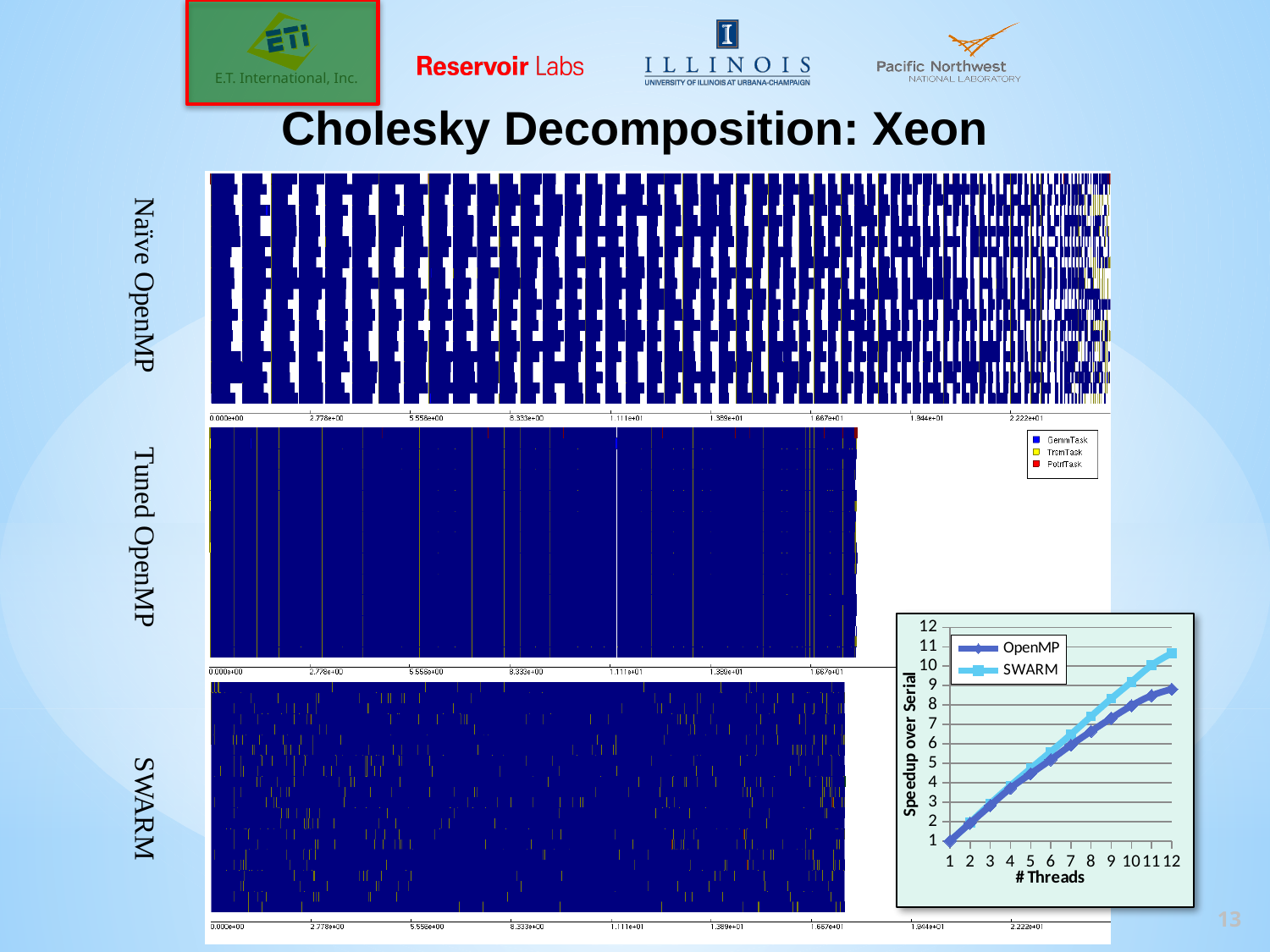
In the speedup chart, is the OpenMP speedup at 12 threads greater or less than 10? less In the speedup chart, which series reaches the highest speedup over serial? SWARM In the speedup chart, does the OpenMP speedup rise or fall as the number of threads increases? rise In the speedup chart, is the SWARM speedup at 12 threads greater or less than 10? greater In the speedup chart, which series has the higher speedup at 12 threads, OpenMP or SWARM? SWARM In the speedup chart, does the SWARM speedup rise or fall as the number of threads increases? rise Which two series are listed in the legend of the speedup chart? OpenMP and SWARM How many series does the legend of the speedup chart list? 2 What kind of chart is the speedup chart in the lower right of the slide? line chart In the speedup chart, is the SWARM speedup at 8 threads greater or less than 7? greater What is the x-axis label of the speedup chart? # Threads How many thread counts are plotted along the x axis of the speedup chart? 12